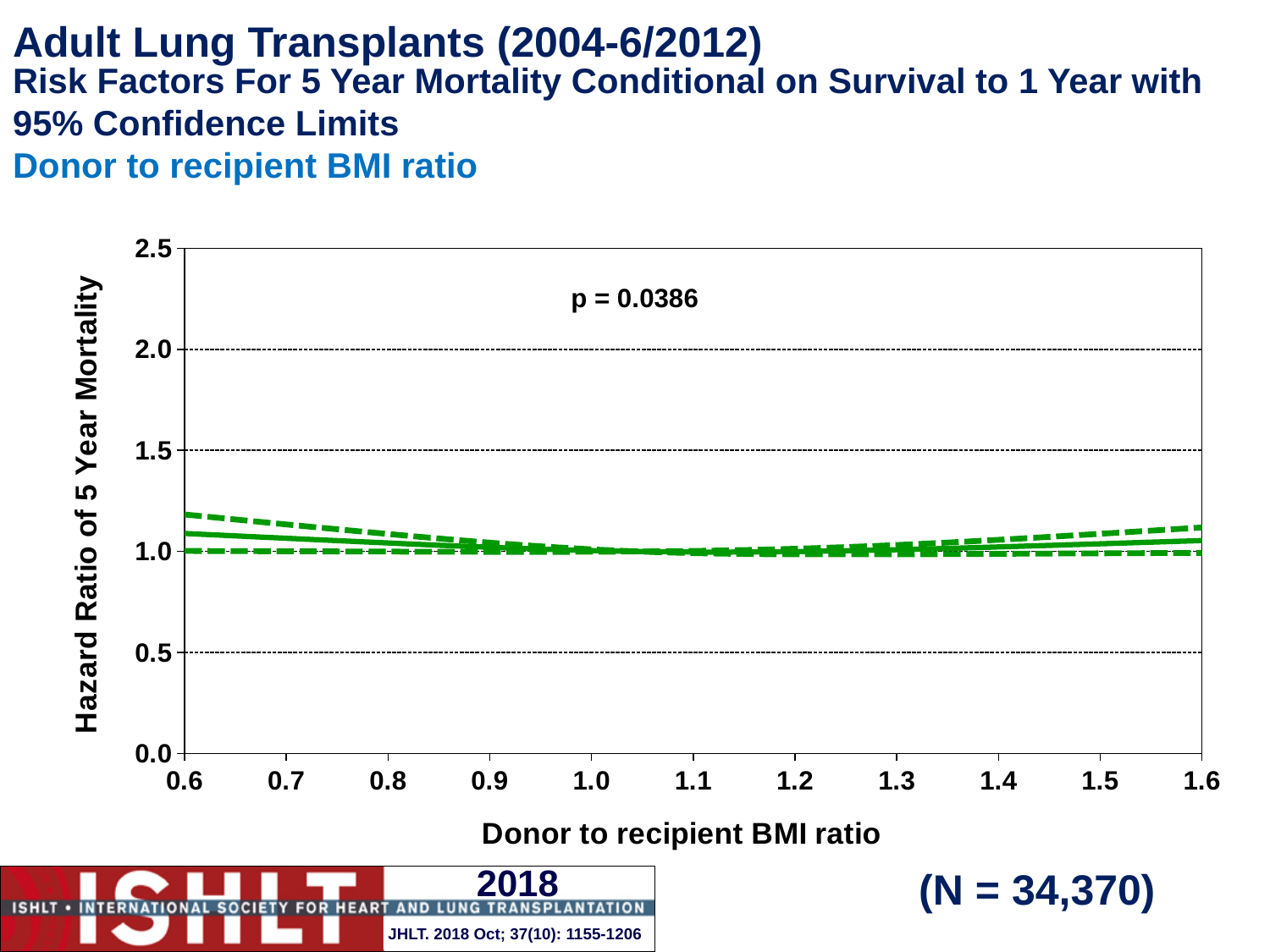
Is the hazard ratio at a donor to recipient BMI ratio of 0.6 greater or less than 1.5? less How many tick labels are shown on the x axis? 11 What is the label of the y axis? Hazard Ratio of 5 Year Mortality Does the solid hazard ratio line fall or rise as the donor to recipient BMI ratio goes from 1.2 to 1.6? rises What is the p-value printed on the chart? p = 0.0386 Does the solid hazard ratio line fall or rise as the donor to recipient BMI ratio goes from 0.6 to 1.0? falls What is the highest value labelled on the y axis? 2.5 What is the label of the x axis? Donor to recipient BMI ratio What kind of chart is shown on the slide? Line chart What sample size (N) is printed on the slide? N = 34,370 Is the hazard ratio at a donor to recipient BMI ratio of 1.0 greater or less than 0.5? greater Is the hazard ratio at a donor to recipient BMI ratio of 1.6 greater or less than 2.0? less